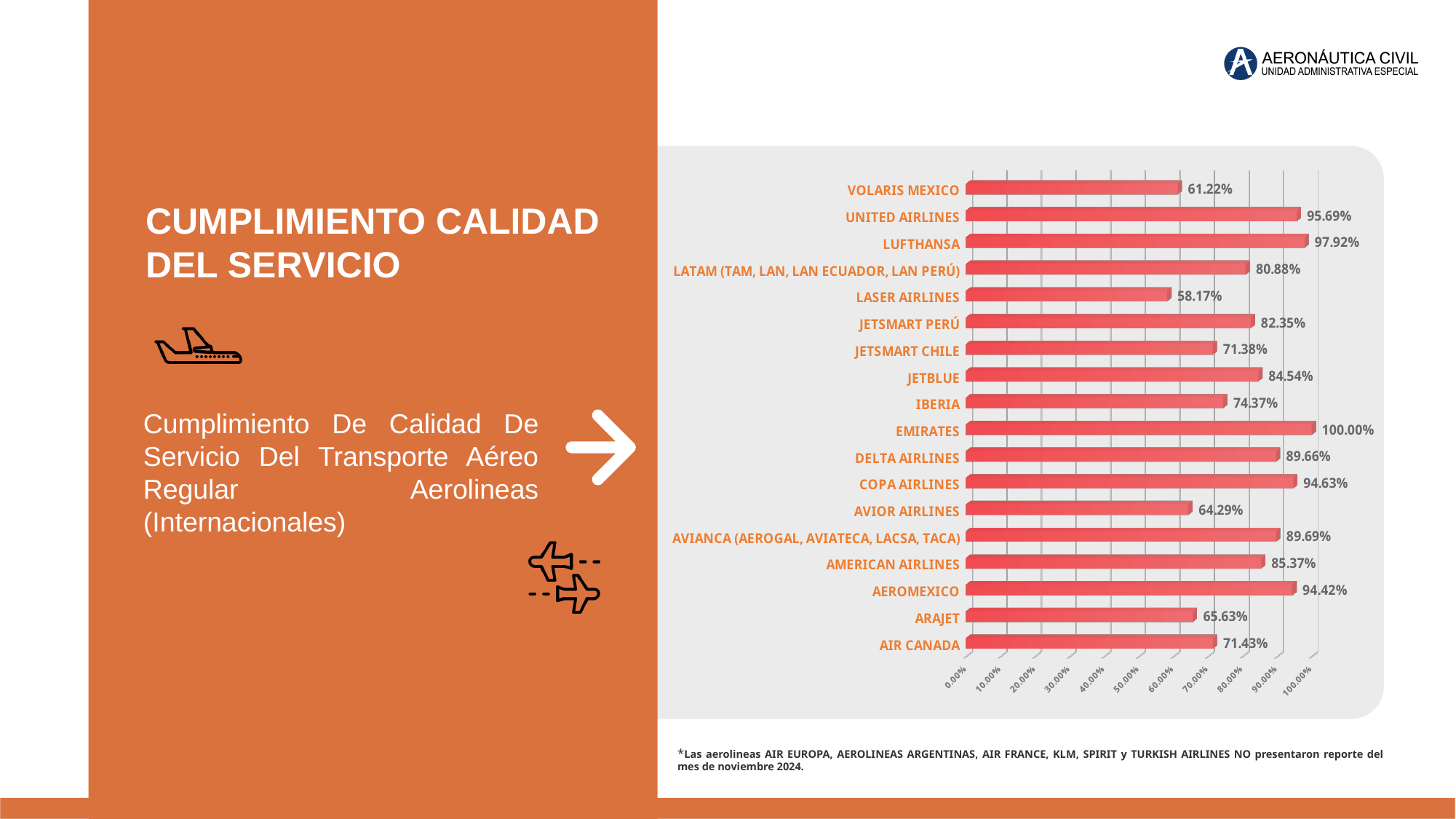
What is the difference between the values for EMIRATES and LASER AIRLINES? 41.83% Which airline has the highest value on the chart? EMIRATES Which airline has the lowest value on the chart? LASER AIRLINES Which has a larger value, JETBLUE or IBERIA? JETBLUE What is the difference between the values for LUFTHANSA and UNITED AIRLINES? 2.23% What is the value for LATAM (TAM, LAN, LAN ECUADOR, LAN PERÚ)? 80.88% Is the value for AVIOR AIRLINES greater or less than 70.00%? less What is the value for EMIRATES? 100.00% What is the value for LASER AIRLINES? 58.17% How many airlines are shown on the chart? 18 What is the value for AIR CANADA? 71.43% What kind of chart is shown on the slide? bar chart